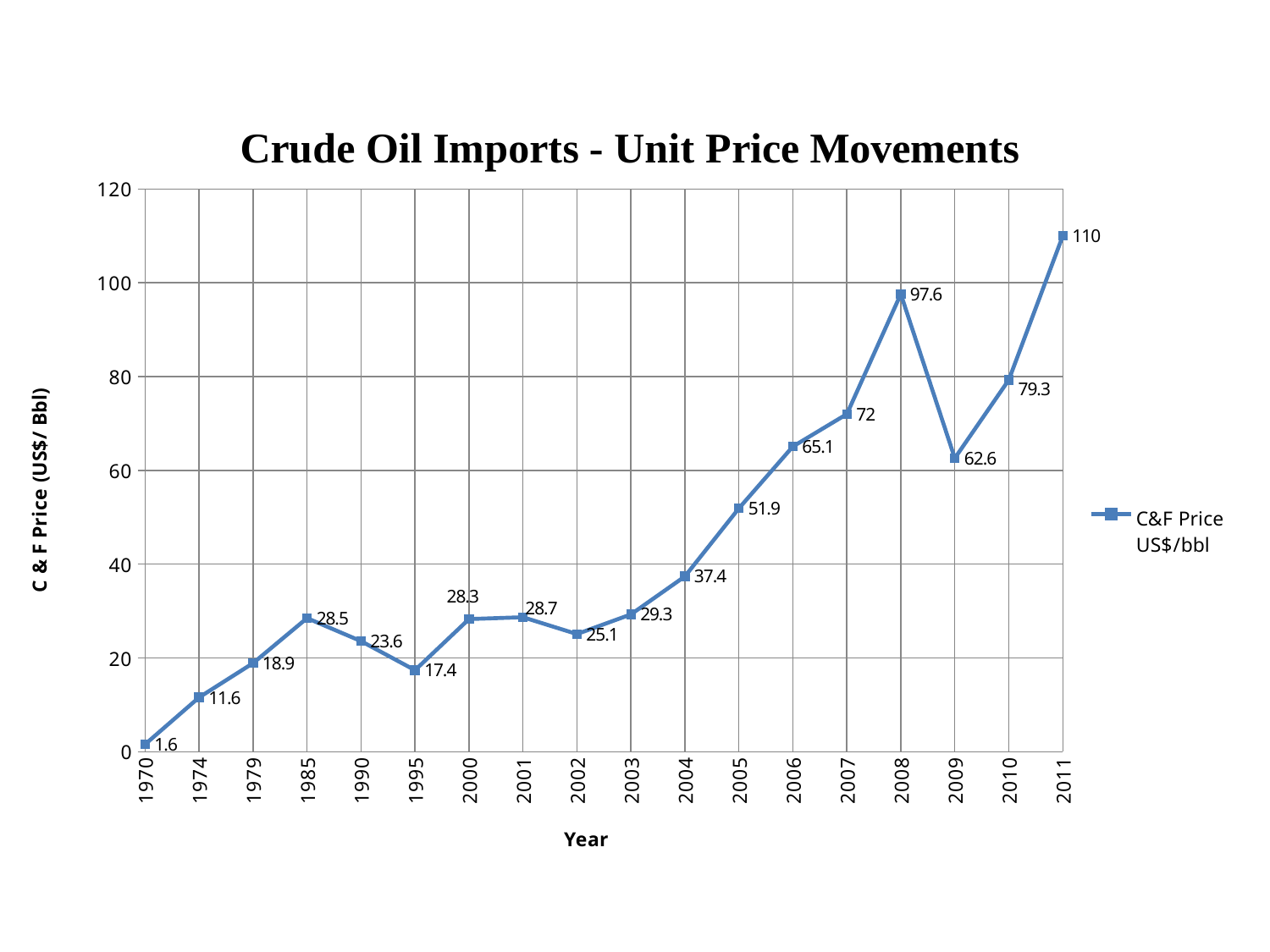
How many years are plotted on the chart? 18 What is the title of the chart? Crude Oil Imports - Unit Price Movements What kind of chart is shown on the slide? line chart Is the C&F price for 2006 greater or less than 60? greater What is the C&F price for 1995? 17.4 What is the C&F price for 2008? 97.6 Which year has the lowest C&F price? 1970 What is the difference between the C&F price in 2008 and in 2009? 35 Which year has a higher C&F price, 2007 or 2009? 2007 Which year has the highest C&F price? 2011 What is the C&F price for 2005? 51.9 What is the difference between the C&F price in 2011 and in 2010? 30.7